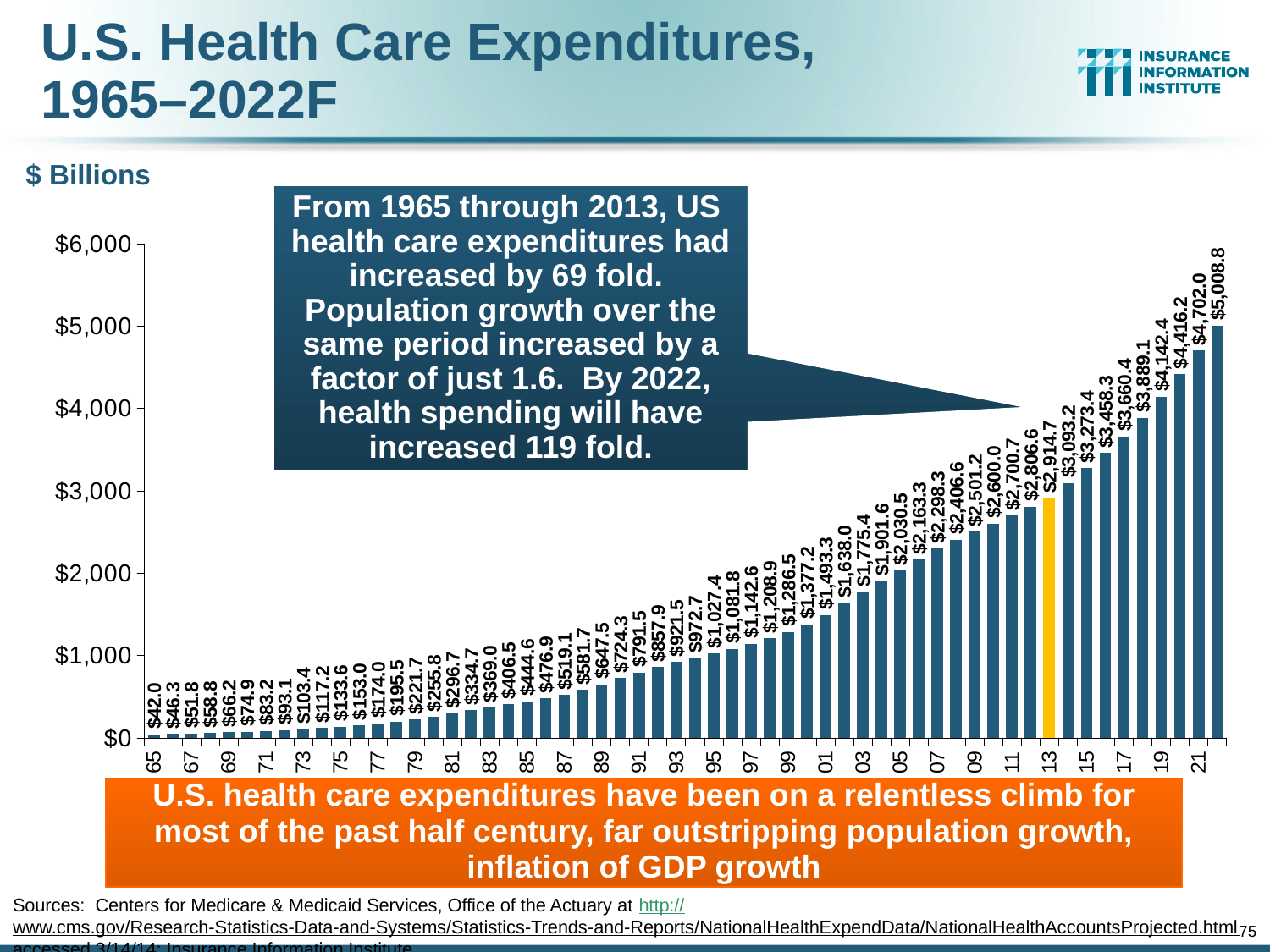
Which is larger, the value for 1995 or the value for 2001? 2001 What is the value for 2005? $2,030.5 What is the value for 2013 (the highlighted bar)? $2,914.7 Which year has the lowest expenditure? 1965 Do the values rise or fall from 1965 to 2022? Rise How many bars are plotted on the chart? 58 What is the highest value shown on the chart? $5,008.8 What kind of chart is this? Bar chart What is the difference between the values for 1975 and 1965? $91.6 What is the value for 1985? $444.6 What is the difference between the values for 2013 and 2011? $214.0 What is the value for 1965? $42.0